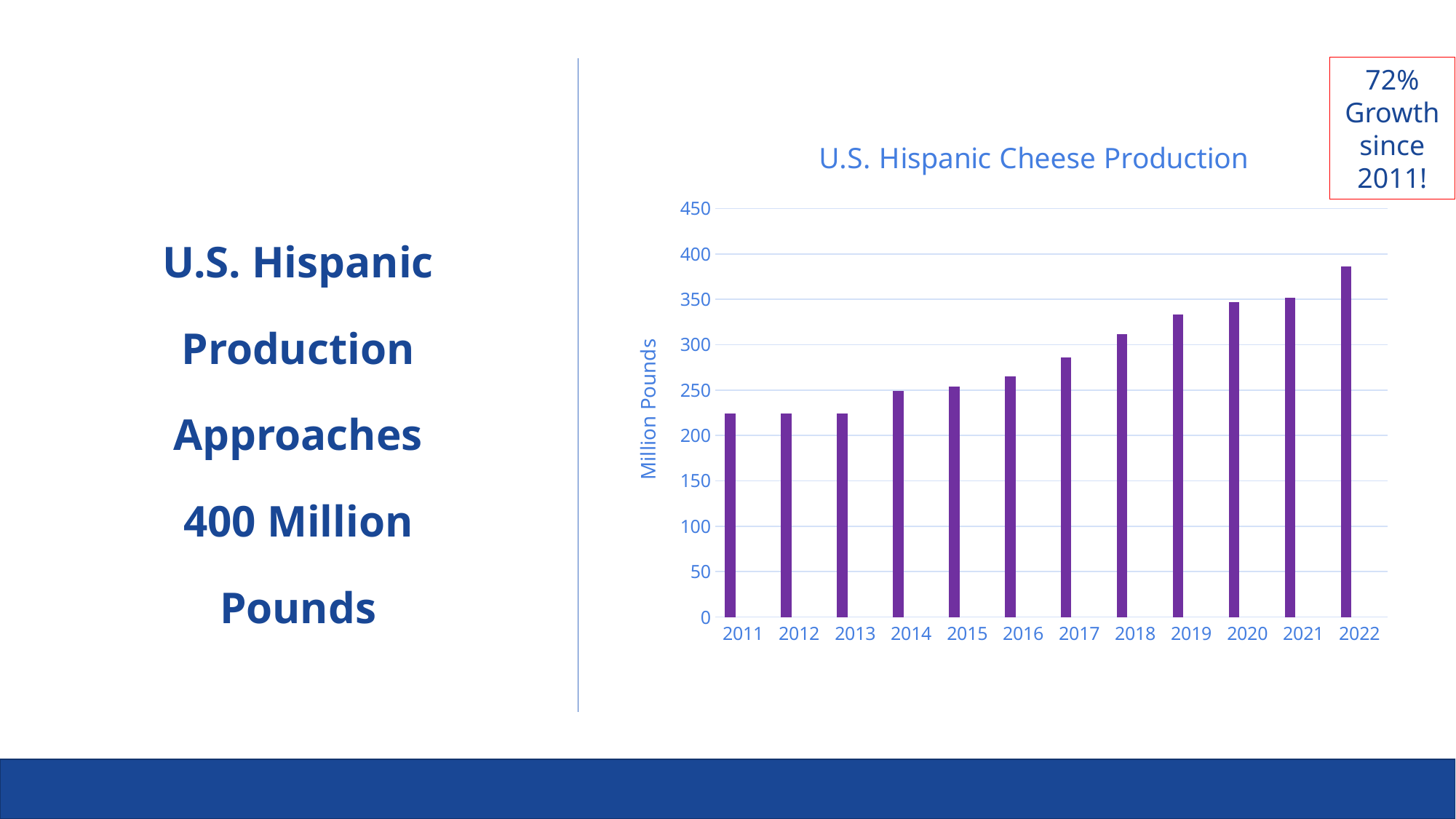
Is the value for 2018 greater or less than 300? greater Do the values generally rise or fall from 2011 to 2022? rise What is the label on the vertical axis of the chart? Million Pounds How many years are plotted on the chart? 12 What is the title of the chart? U.S. Hispanic Cheese Production Is the value for 2011 greater or less than 250? less Is the value for 2019 greater or less than 350? less Which year has the larger value, 2014 or 2018? 2018 Which year has the highest production on the chart? 2022 What type of chart is shown on the slide? bar chart